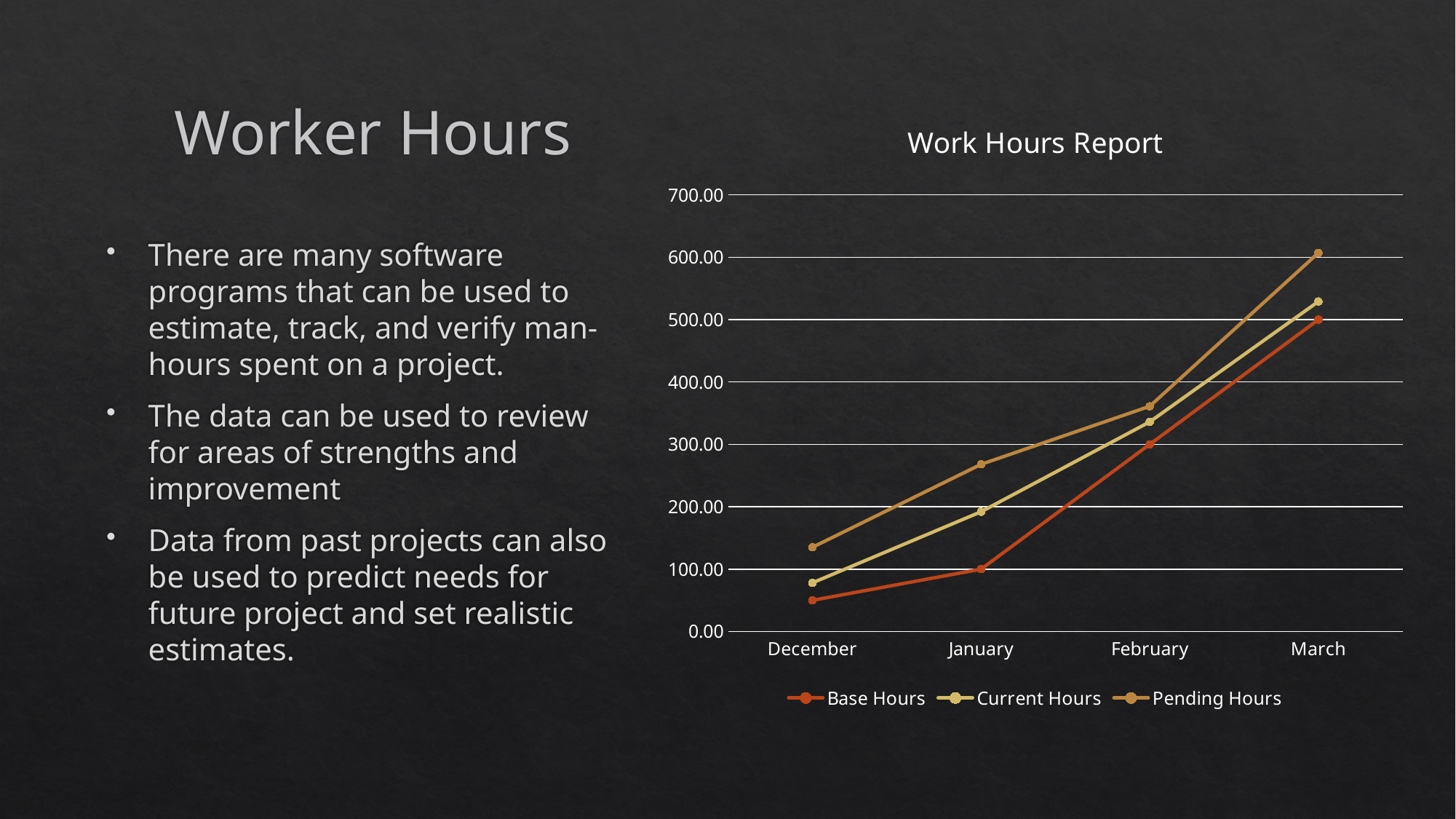
What kind of chart is shown on the slide? line chart In which month are Base Hours lowest? December Do the Base Hours values rise or fall from December to March? rise In December, which is larger: Pending Hours or Base Hours? Pending Hours Is the value for Pending Hours in January greater or less than 200.00? greater Is the value for Pending Hours in March greater or less than 500.00? greater Is the value for Current Hours in December greater or less than 100.00? less How many series does the chart legend list? 3 Which series are listed in the chart legend? Base Hours, Current Hours, Pending Hours How many months are shown on the x axis of the chart? 4 In which month are Pending Hours highest? March What is the title of the chart? Work Hours Report